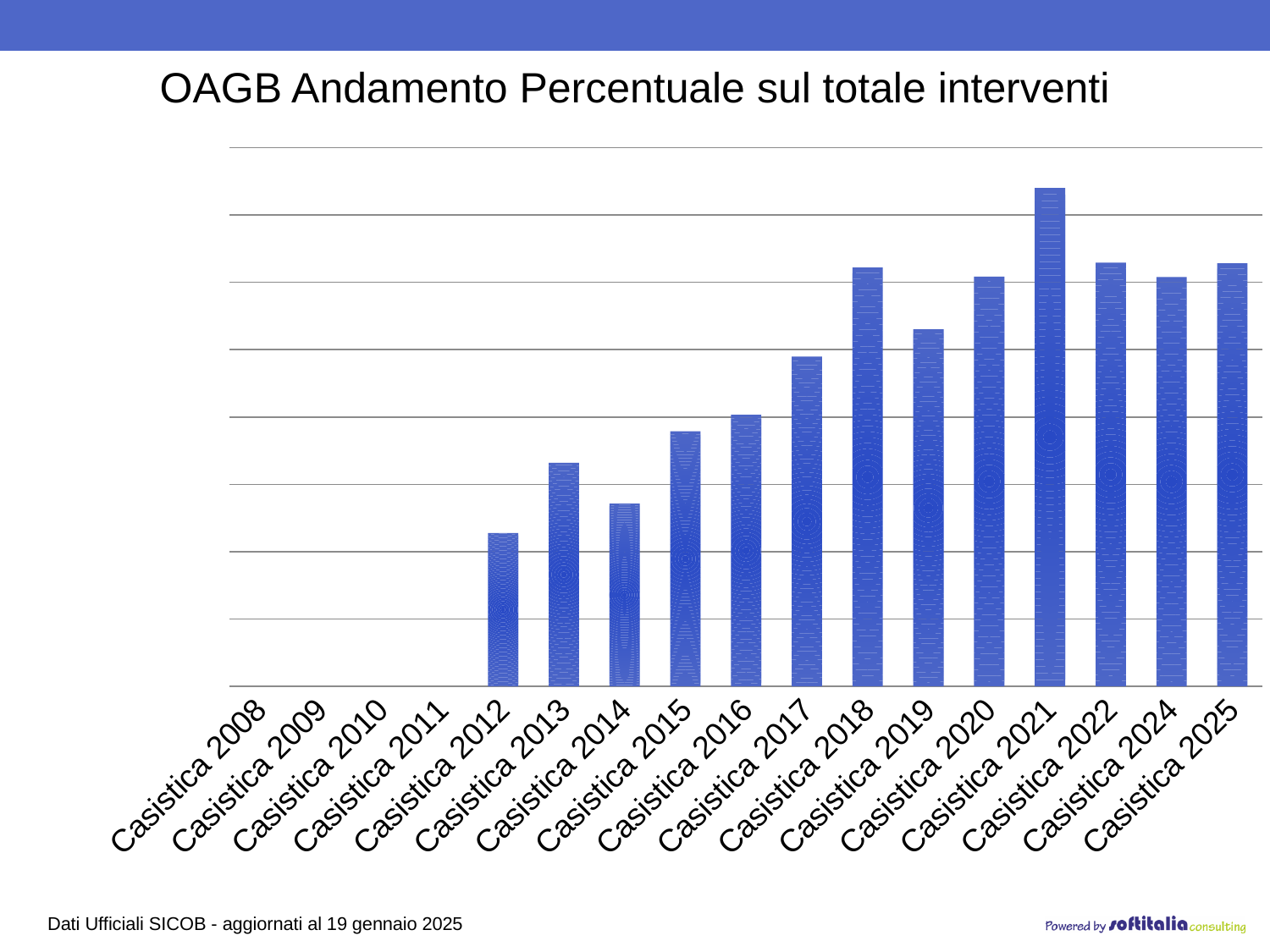
What is the title of the chart? OAGB Andamento Percentuale sul totale interventi Which is larger, the value for Casistica 2018 or Casistica 2019? Casistica 2018 Which is larger, the value for Casistica 2013 or Casistica 2014? Casistica 2013 Which year is missing from the sequence of categories between Casistica 2022 and Casistica 2024? 2023 What kind of chart is shown on the slide? bar chart Which category has the highest bar? Casistica 2021 Do the values rise or fall from Casistica 2014 to Casistica 2018? rise How many categories have no visible bar? 4 Which category has the shortest visible bar? Casistica 2012 Which is larger, the value for Casistica 2021 or Casistica 2022? Casistica 2021 How many categories are shown on the x axis? 17